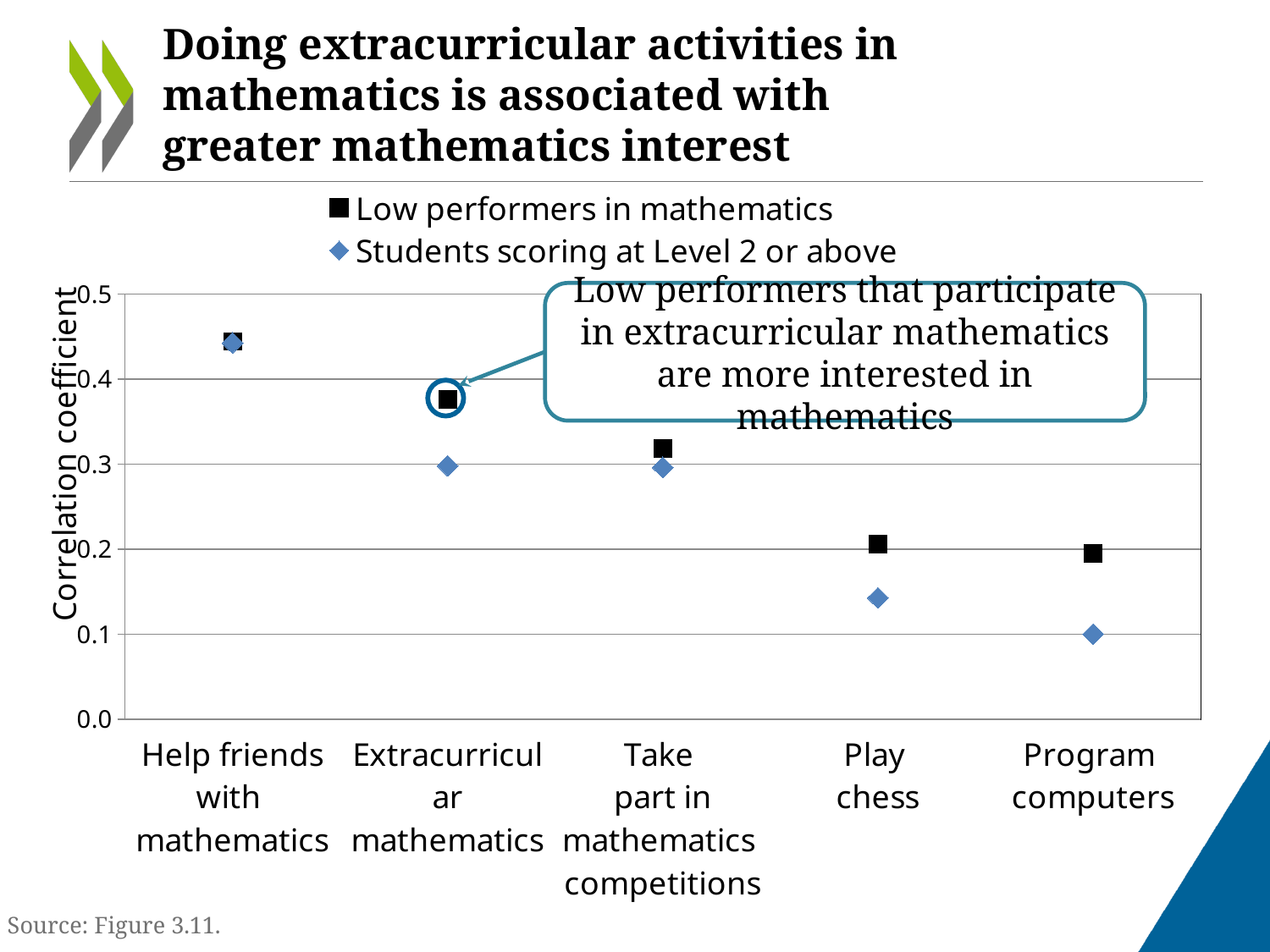
How many series does the chart's legend list? 2 Is the value for 'Extracurricular mathematics' for students scoring at Level 2 or above greater or less than 0.4? less Is the value for 'Play chess' for students scoring at Level 2 or above greater or less than 0.2? less Is the value for 'Extracurricular mathematics' for low performers in mathematics greater or less than 0.4? less What are the two series named in the chart's legend? Low performers in mathematics; Students scoring at Level 2 or above Do the correlation coefficients for students scoring at Level 2 or above generally rise or fall from left to right across the x axis? fall What is the label on the chart's vertical axis? Correlation coefficient For 'Play chess', which series has the larger correlation coefficient: low performers in mathematics or students scoring at Level 2 or above? Low performers in mathematics Which activity has the highest correlation coefficient for low performers in mathematics? Help friends with mathematics How many activity categories are shown on the x axis of the chart? 5 Which activity has the lowest correlation coefficient for students scoring at Level 2 or above? Program computers